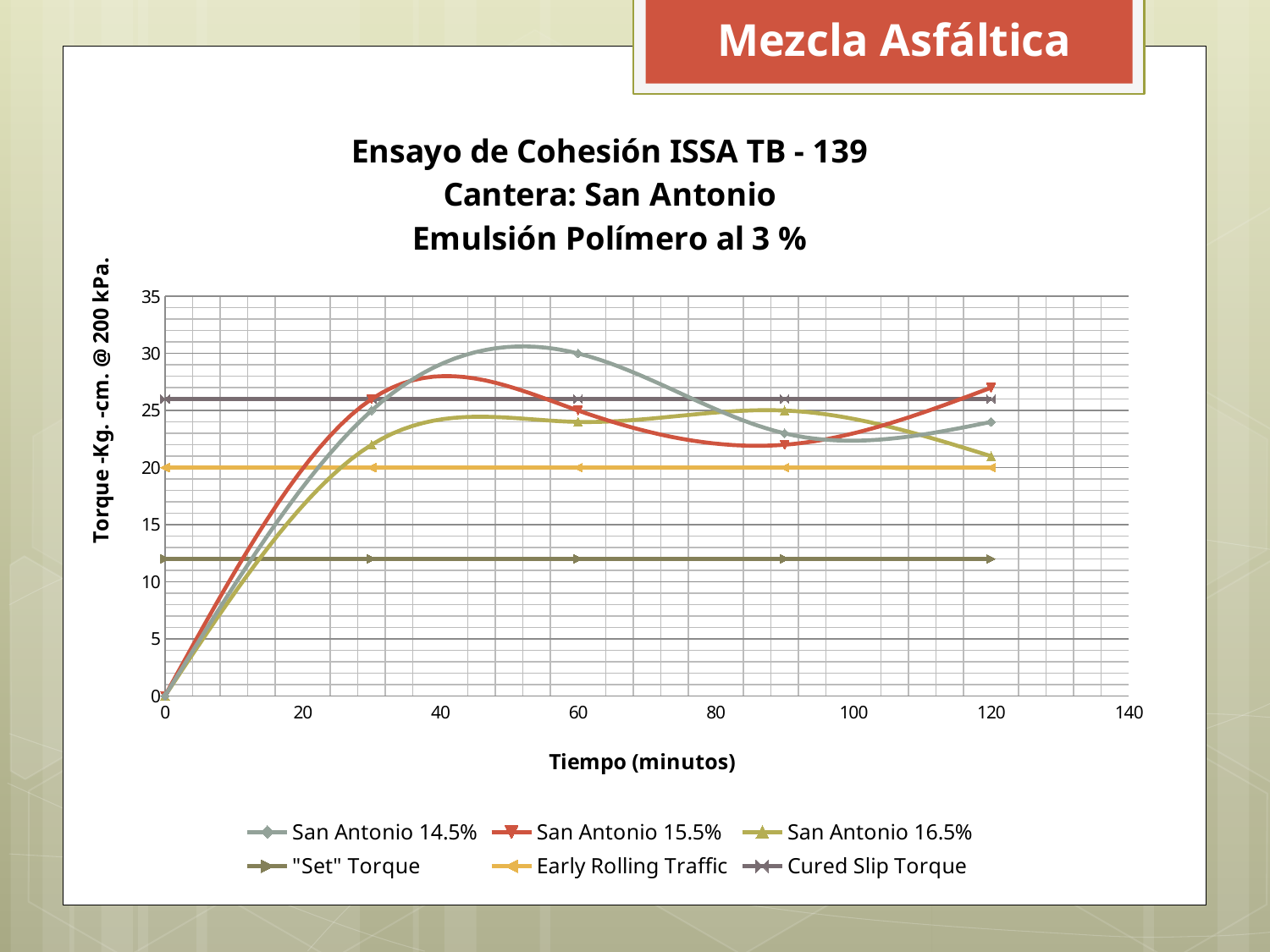
Is the value of the Cured Slip Torque line greater or less than 25? greater What is the value of the Early Rolling Traffic line? 20 Is the value for San Antonio 16.5% at 120 minutes greater or less than 25? less At 120 minutes, which is larger: San Antonio 15.5% or San Antonio 16.5%? San Antonio 15.5% What kind of chart is shown on the slide? line chart How many series does the legend list? 6 What is the label of the x axis? Tiempo (minutos) At 60 minutes, which is larger: San Antonio 14.5% or San Antonio 16.5%? San Antonio 14.5% Is the value for San Antonio 14.5% at 60 minutes greater or less than 25? greater Which of the three San Antonio series has the highest value at 60 minutes? San Antonio 14.5% Does the San Antonio 16.5% series rise or fall between 90 and 120 minutes? fall